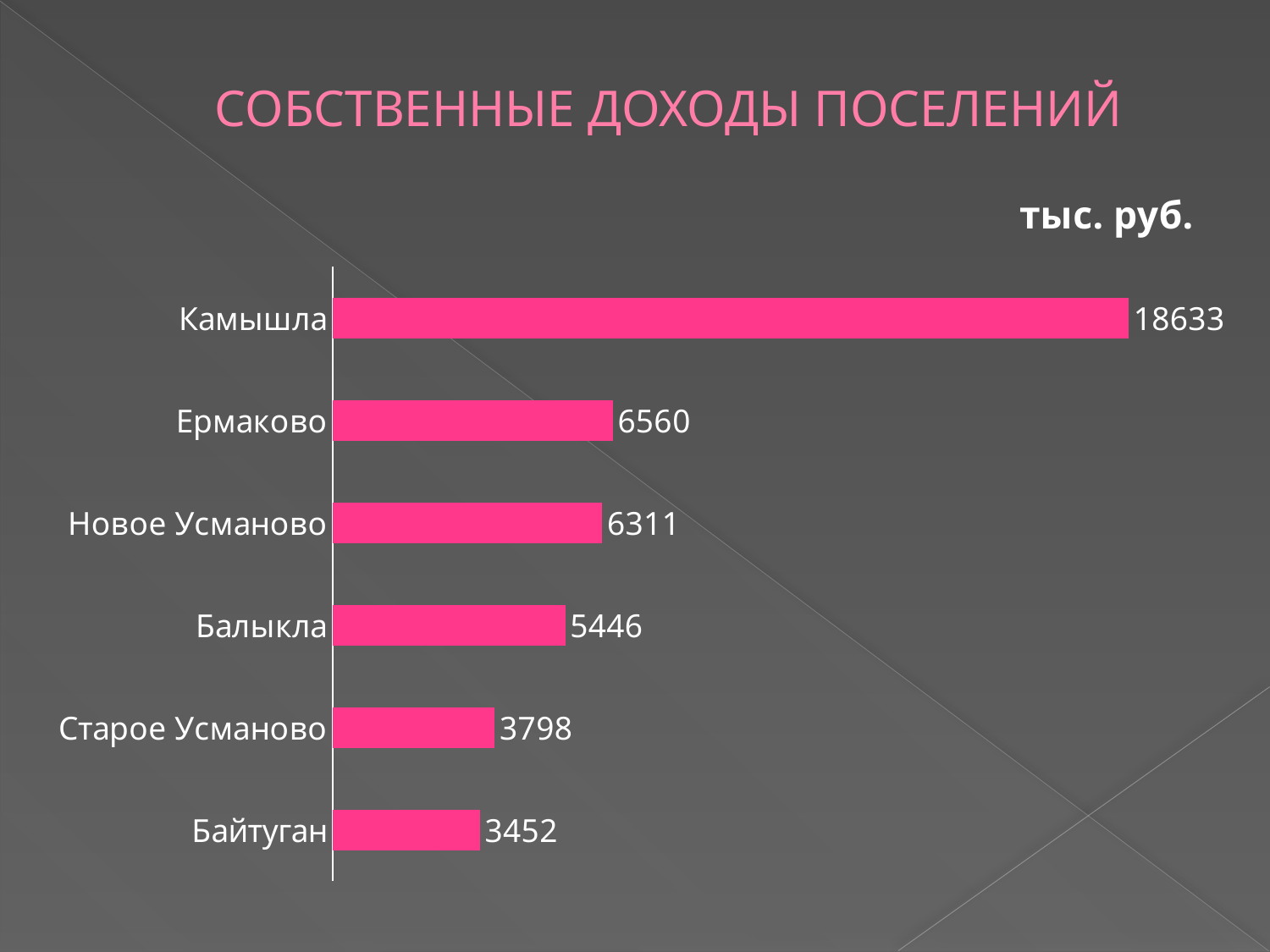
What is the value for Ермаково? 6560 Which is larger, the value for Балыкла or the value for Старое Усманово? Балыкла Which settlement has the lowest own revenue? Байтуган How many settlements are shown in the chart? 6 What is the value for Балыкла? 5446 What kind of chart is shown on the slide? Bar chart What is the value for Старое Усманово? 3798 What is the difference between the values for Камышла and Ермаково? 12073 What is the value for Новое Усманово? 6311 Which settlement has the highest own revenue? Камышла What is the value for Камышла? 18633 What is the value for Байтуган? 3452